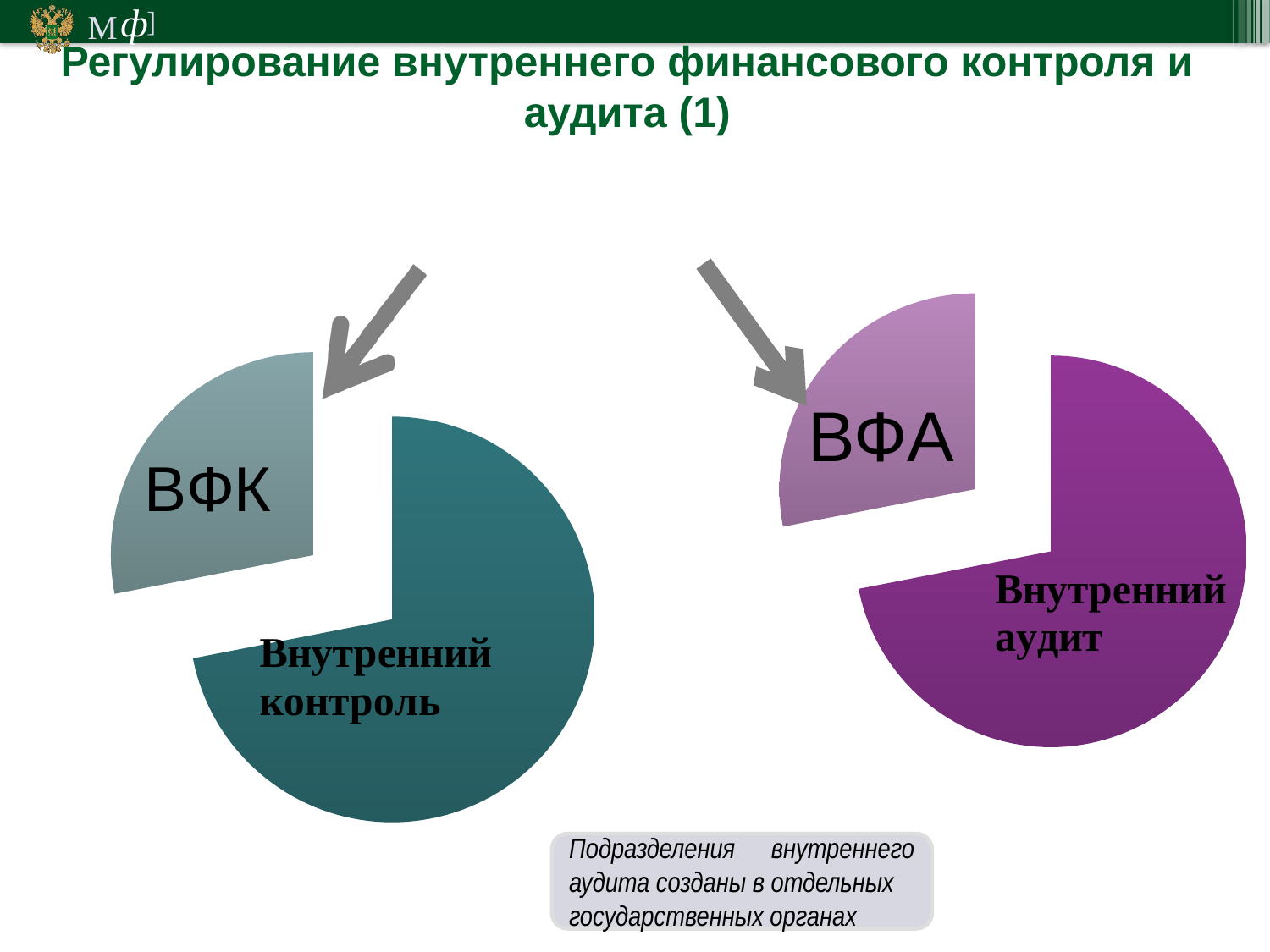
In the right pie chart, which slice is larger: ВФА or Внутренний аудит? Внутренний аудит How many slices does the left pie chart have? 2 In the left pie chart, which slice is the largest? Внутренний контроль In the right pie chart, which slice is the smallest? ВФА How many slices does the right pie chart have? 2 What kind of chart is the right chart on the slide? pie chart What kind of chart is the left chart on the slide? pie chart What colour is the large slice of the right pie chart? purple In the right pie chart, which slice is the largest? Внутренний аудит In the left pie chart, which slice is the smallest? ВФК In the left pie chart, which slice is larger: ВФК or Внутренний контроль? Внутренний контроль What is the title of the slide containing the two pie charts? Регулирование внутреннего финансового контроля и аудита (1)